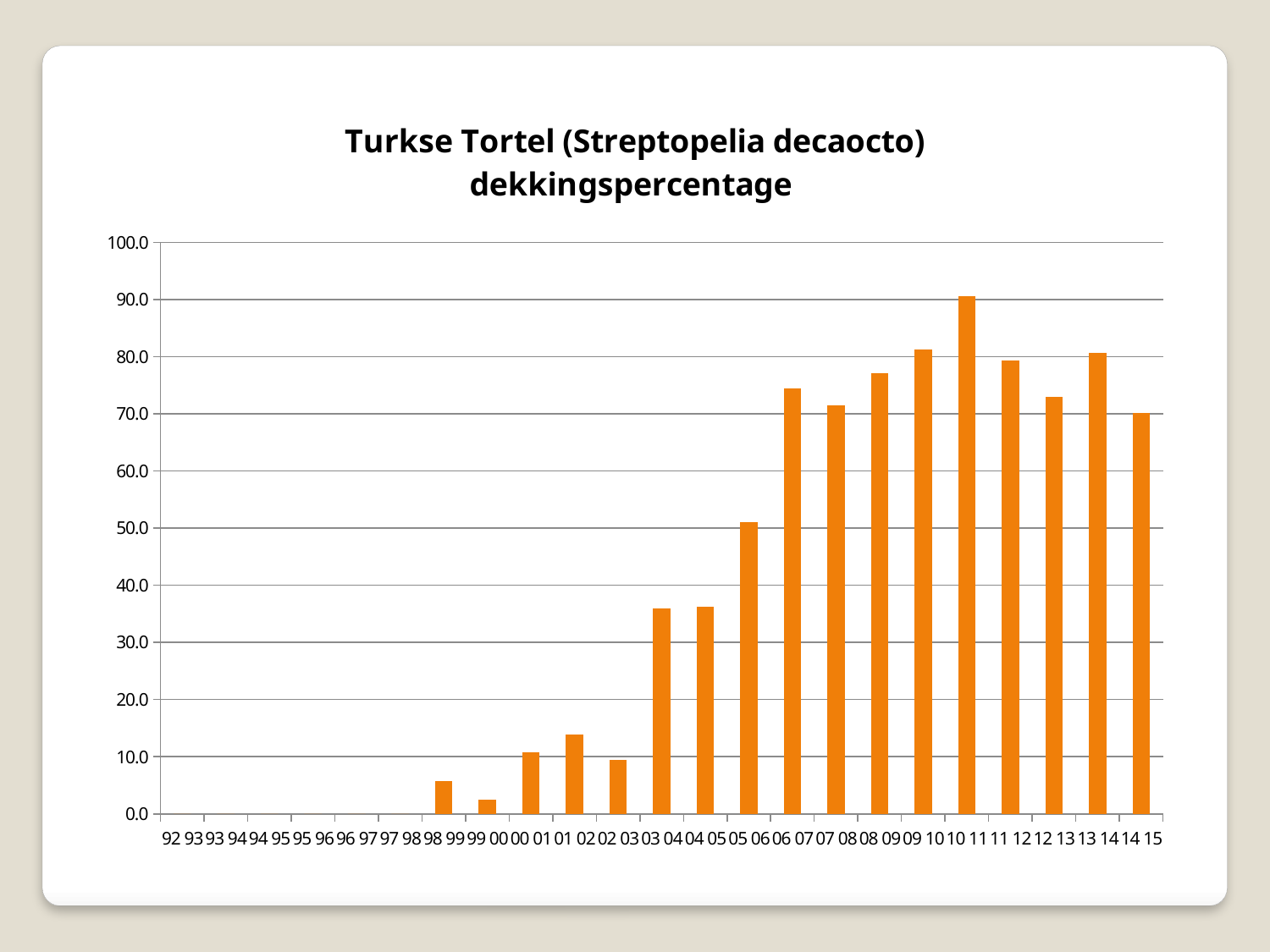
What colour are the bars in the chart? Orange Which season has the highest dekkingspercentage? 10 11 Is the value for season 08 09 greater or less than 70.0? greater What is the title of the chart? Turkse Tortel (Streptopelia decaocto) dekkingspercentage How many seasons have a visible bar in the chart? 17 Is the value for season 01 02 greater or less than 10.0? greater Does the dekkingspercentage generally rise or fall from season 98 99 to season 10 11? Rise Is the value for season 03 04 greater or less than 30.0? greater Among the seasons with a visible bar, which has the lowest dekkingspercentage? 99 00 What kind of chart is shown on the slide? Bar chart Which is larger, the value for season 05 06 or season 06 07? 06 07